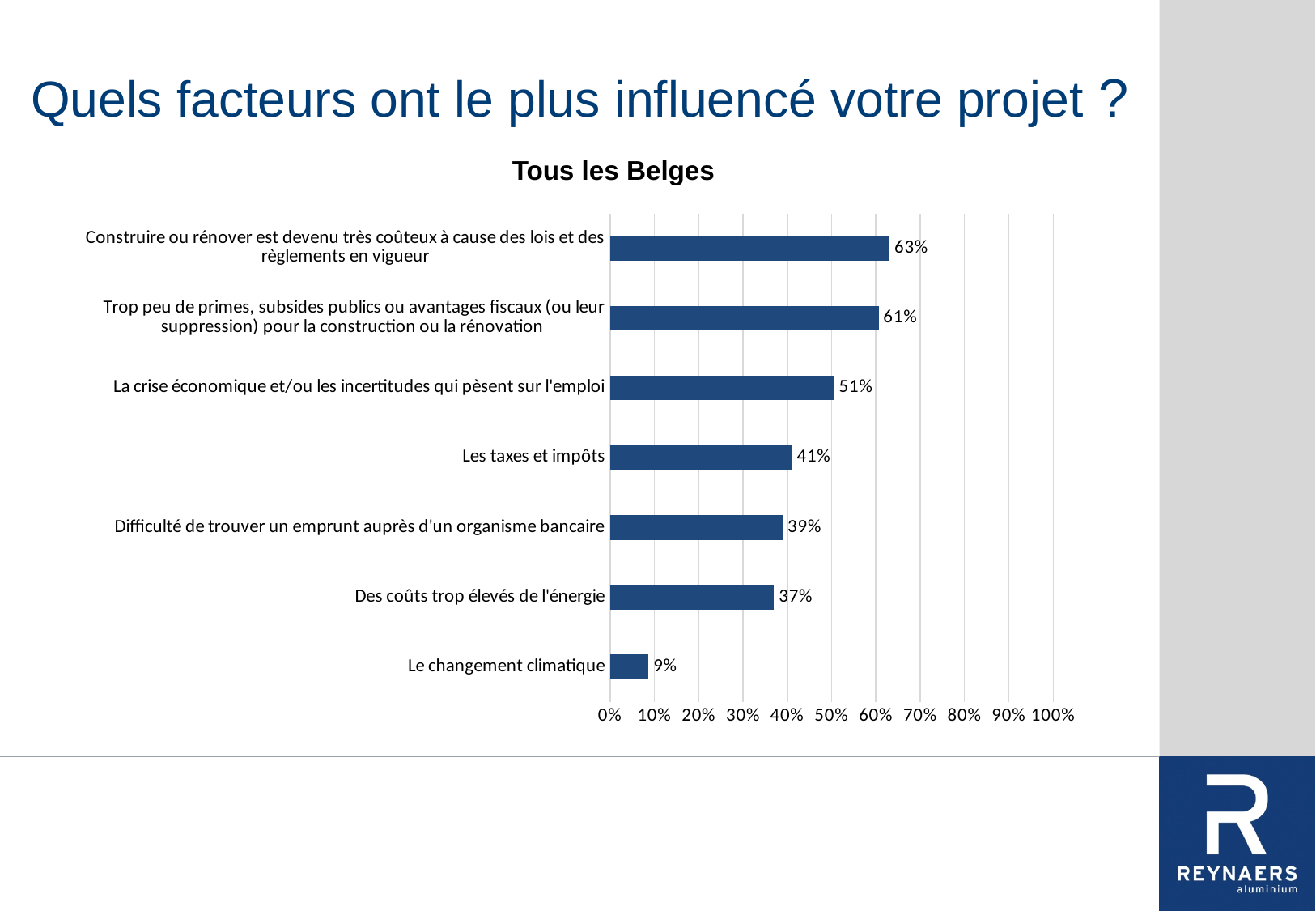
What is the difference between the values for "Construire ou rénover est devenu très coûteux à cause des lois et des règlements en vigueur" and "Trop peu de primes, subsides publics ou avantages fiscaux (ou leur suppression) pour la construction ou la rénovation"? 2% What is the value for "La crise économique et/ou les incertitudes qui pèsent sur l'emploi"? 51% How many categories are shown in the chart? 7 Which category has the highest value? Construire ou rénover est devenu très coûteux à cause des lois et des règlements en vigueur Which category has the lowest value? Le changement climatique What is the value for "Les taxes et impôts"? 41% What kind of chart is shown on the slide? Bar chart Is the value for "Des coûts trop élevés de l'énergie" greater or less than 40%? less Which is larger: the value for "Les taxes et impôts" or the value for "Difficulté de trouver un emprunt auprès d'un organisme bancaire"? Les taxes et impôts What is the title of the chart? Tous les Belges What is the value for "Des coûts trop élevés de l'énergie"? 37% What is the value for "Le changement climatique"? 9%